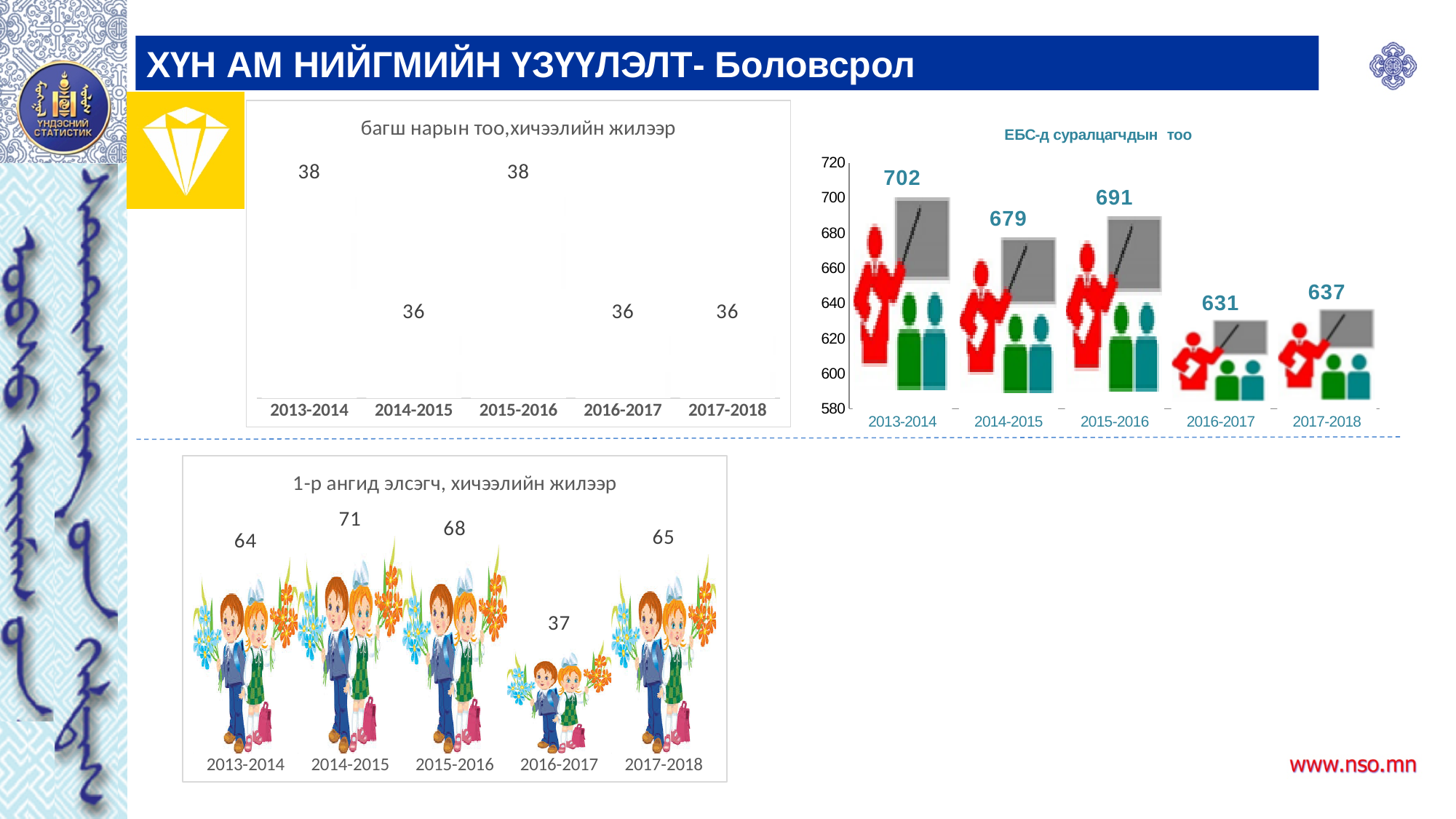
In the chart titled 'ЕБС-д суралцагчдын тоо', is the value for 2015-2016 greater or less than 680? greater In the chart titled '1-р ангид элсэгч, хичээлийн жилээр', which school year has the highest value? 2014-2015 In the chart titled 'ЕБС-д суралцагчдын тоо', which school year has the lowest value? 2016-2017 In the chart titled 'ЕБС-д суралцагчдын тоо', what is the value for 2013-2014? 702 In the chart titled '1-р ангид элсэгч, хичээлийн жилээр', what is the value for 2016-2017? 37 In the chart titled 'багш нарын тоо,хичээлийн жилээр', what is the value for 2014-2015? 36 In the chart titled '1-р ангид элсэгч, хичээлийн жилээр', what is the difference between the values for 2014-2015 and 2016-2017? 34 In the chart titled 'багш нарын тоо,хичээлийн жилээр', which school years have the highest value? 2013-2014 and 2015-2016 In the chart titled 'ЕБС-д суралцагчдын тоо', how many school years are shown on the x axis? 5 In the chart titled 'ЕБС-д суралцагчдын тоо', what is the difference between the values for 2013-2014 and 2017-2018? 65 In the chart titled '1-р ангид элсэгч, хичээлийн жилээр', which is larger, the value for 2015-2016 or the value for 2017-2018? 2015-2016 In the chart titled 'багш нарын тоо,хичээлийн жилээр', what is the difference between the values for 2013-2014 and 2014-2015? 2